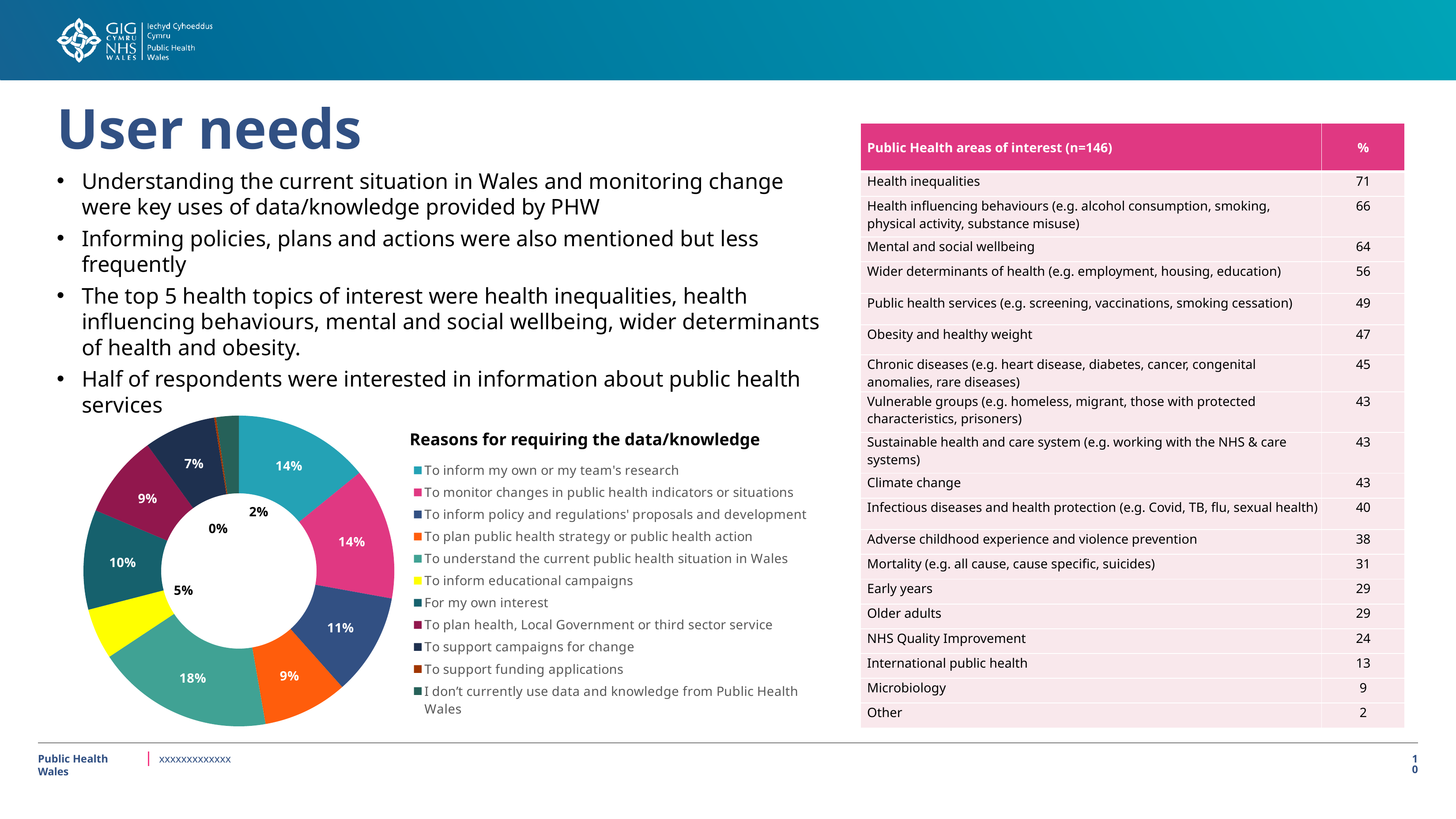
What is the title of the chart on the slide? Reasons for requiring the data/knowledge What percentage is shown for 'To support campaigns for change'? 7% What kind of chart is shown on the slide? doughnut chart What is the difference in percentage points between 'To understand the current public health situation in Wales' and 'To inform educational campaigns'? 13 percentage points Which is larger: the share for 'For my own interest' or for 'To plan public health strategy or public health action'? For my own interest Which reason has the smallest share of the chart? To support funding applications What percentage is shown for 'I don't currently use data and knowledge from Public Health Wales'? 2% How many reasons (categories) does the chart show? 11 What percentage of respondents selected 'To understand the current public health situation in Wales'? 18% How many entries does the chart's legend list? 11 Which reason has the largest share of the chart? To understand the current public health situation in Wales What percentage is shown for 'To inform educational campaigns'? 5%